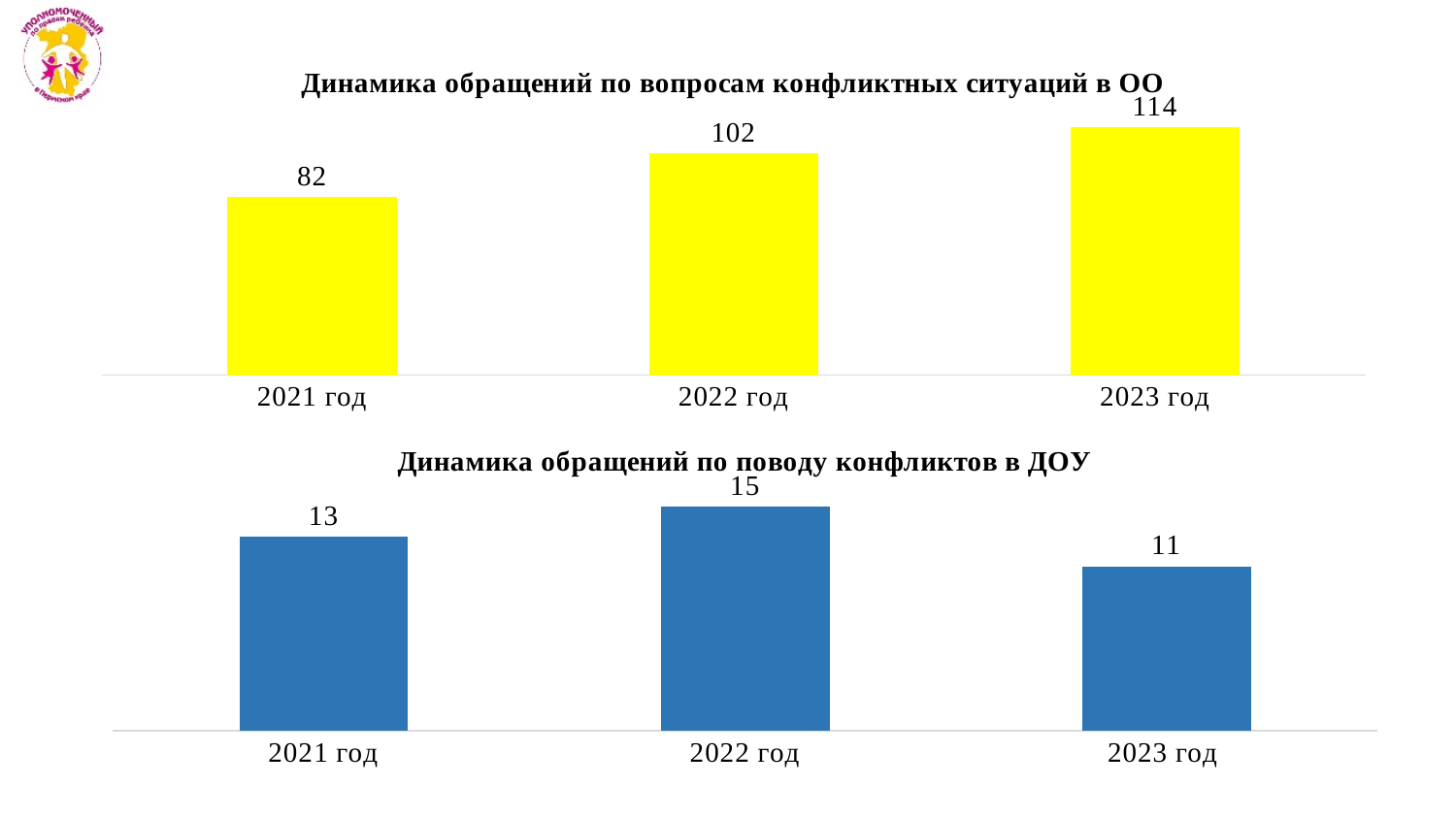
In the bottom chart (Динамика обращений по поводу конфликтов в ДОУ), what is the difference between the values for 2022 год and 2023 год? 4 In the top chart (Динамика обращений по вопросам конфликтных ситуаций в ОО), what is the value for 2023 год? 114 In the top chart (Динамика обращений по вопросам конфликтных ситуаций в ОО), do the values rise or fall from 2021 год to 2023 год? rise What colour are the bars in the bottom chart (Динамика обращений по поводу конфликтов в ДОУ)? blue In the top chart (Динамика обращений по вопросам конфликтных ситуаций в ОО), what is the value for 2021 год? 82 In the bottom chart (Динамика обращений по поводу конфликтов в ДОУ), which is larger, the value for 2021 год or 2023 год? 2021 год What type of chart is the top chart (Динамика обращений по вопросам конфликтных ситуаций в ОО)? bar chart In the bottom chart (Динамика обращений по поводу конфликтов в ДОУ), what is the value for 2022 год? 15 How many bars are in the bottom chart (Динамика обращений по поводу конфликтов в ДОУ)? 3 In the bottom chart (Динамика обращений по поводу конфликтов в ДОУ), which year has the lowest value? 2023 год In the top chart (Динамика обращений по вопросам конфликтных ситуаций в ОО), what is the difference between the values for 2023 год and 2021 год? 32 In the top chart (Динамика обращений по вопросам конфликтных ситуаций в ОО), which year has the highest value? 2023 год